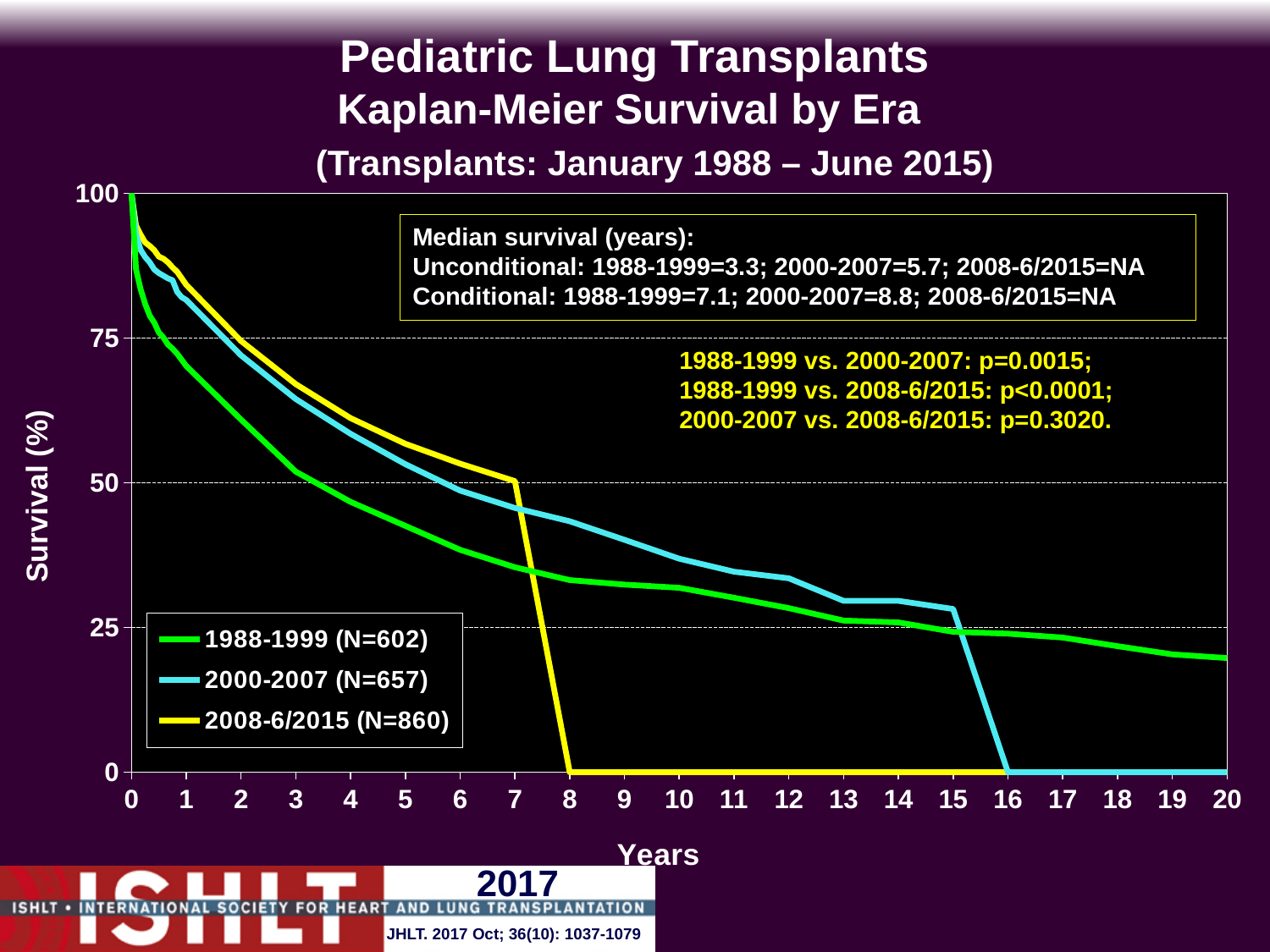
What is the difference in unconditional median survival (years) between the 2000-2007 era and the 1988-1999 era? 2.4 What is the p-value for 1988-1999 vs. 2000-2007? p=0.0015 At 5 years, which era has higher survival, 1988-1999 or 2008-6/2015? 2008-6/2015 What kind of chart is shown on the slide? line chart How many series does the legend list? 3 What is the N for the 2008-6/2015 era in the legend? 860 What is the unconditional median survival in years for the 2000-2007 era? 5.7 Do the survival curves rise or fall as years increase? fall Is the survival value for the 1988-1999 era at 10 years greater or less than 50? less What is the conditional median survival in years for the 1988-1999 era? 7.1 Is the survival value for the 2008-6/2015 era at 3 years greater or less than 50? greater Which era has the largest N in the legend? 2008-6/2015